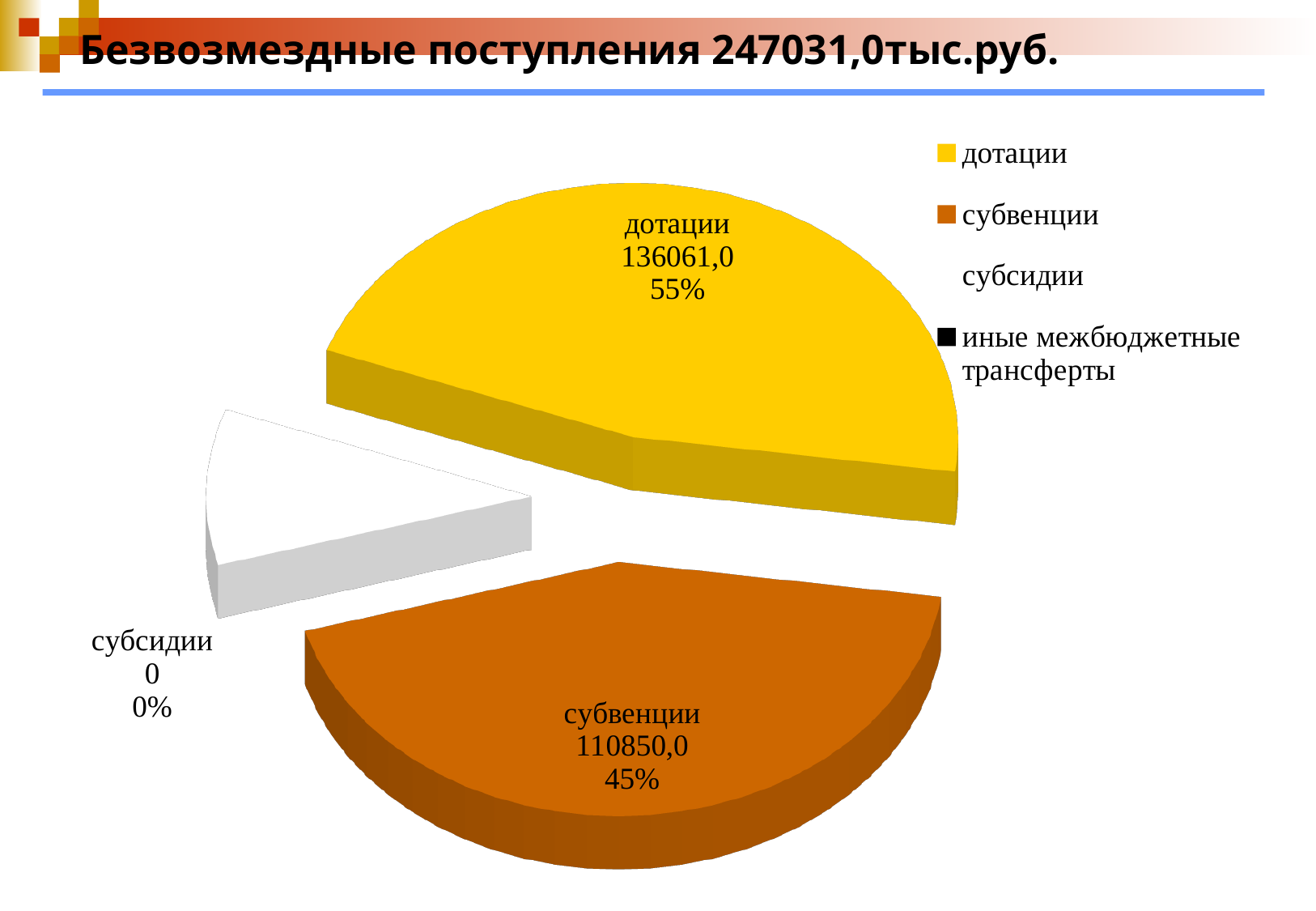
What is the title of the slide? Безвозмездные поступления 247031,0тыс.руб. What is the difference between the values for дотации and субвенции? 25211,0 What value is shown for дотации? 136061,0 Which category has the largest slice of the pie? дотации What colour is the slice for субвенции? orange-brown What percentage share is shown for дотации? 55% Which is larger, the value for дотации or the value for субвенции? дотации What percentage share is shown for субсидии? 0% What value is shown for субвенции? 110850,0 What percentage share is shown for субвенции? 45% How many entries does the legend list? 4 What kind of chart is shown on the slide? pie chart